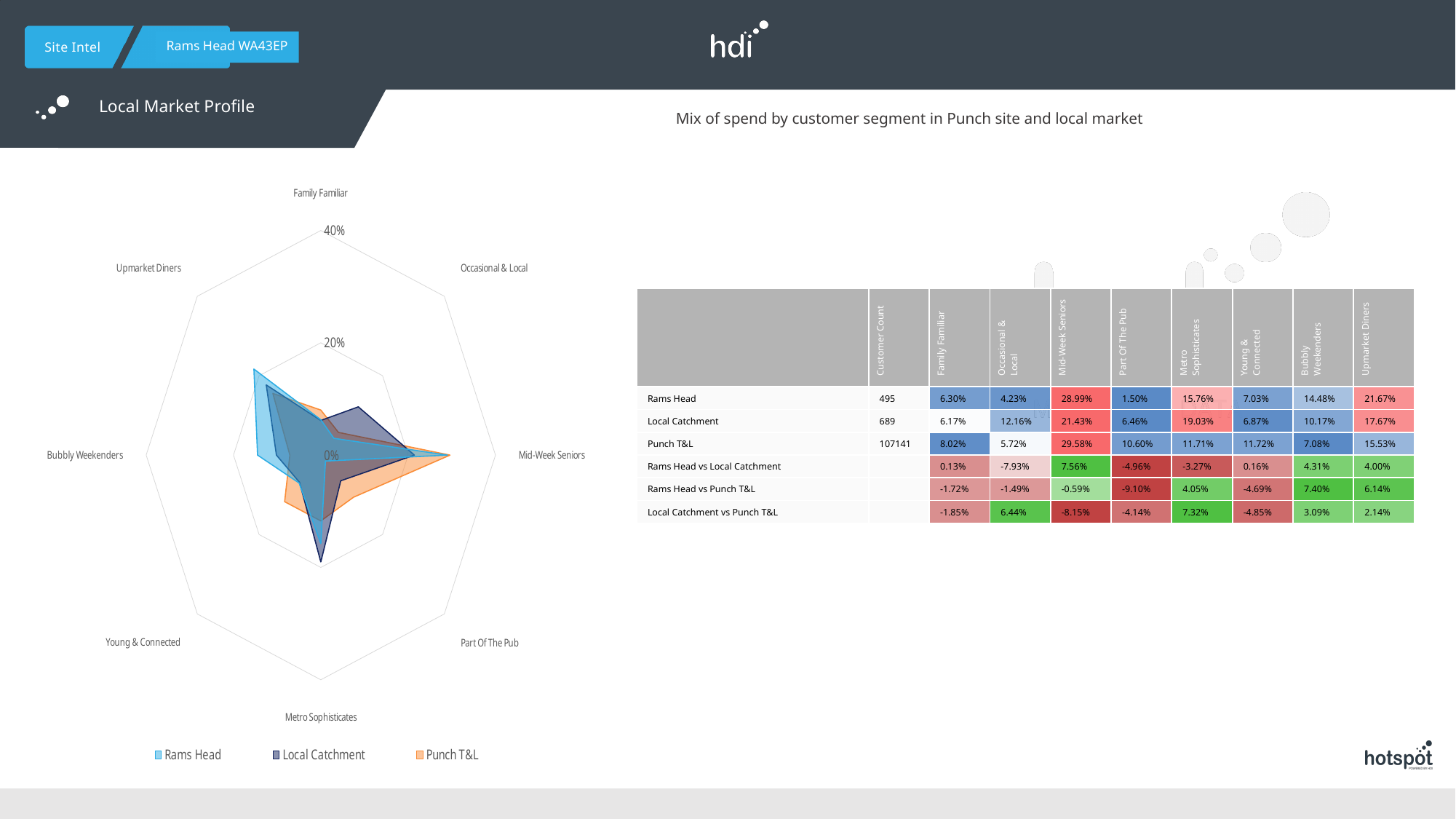
How many series does the legend of the radar chart list? 3 Which series is shown in light blue on the radar chart? Rams Head Is the Local Catchment value for Upmarket Diners greater or less than 20%? less Is the Rams Head value for Mid-Week Seniors greater or less than 20%? greater For Upmarket Diners, which is larger: Rams Head or Punch T&L? Rams Head What is the highest percentage tick shown on the radar chart's axis? 40% What is the Rams Head value for Mid-Week Seniors? 28.99% What is the difference between Rams Head and Local Catchment for Mid-Week Seniors? 7.56% Which customer segment has the lowest value for Rams Head? Part Of The Pub How many customer segment categories are plotted on the radar chart? 8 What kind of chart is shown on the left of the slide? Radar chart Which customer segment has the highest value for Rams Head? Mid-Week Seniors